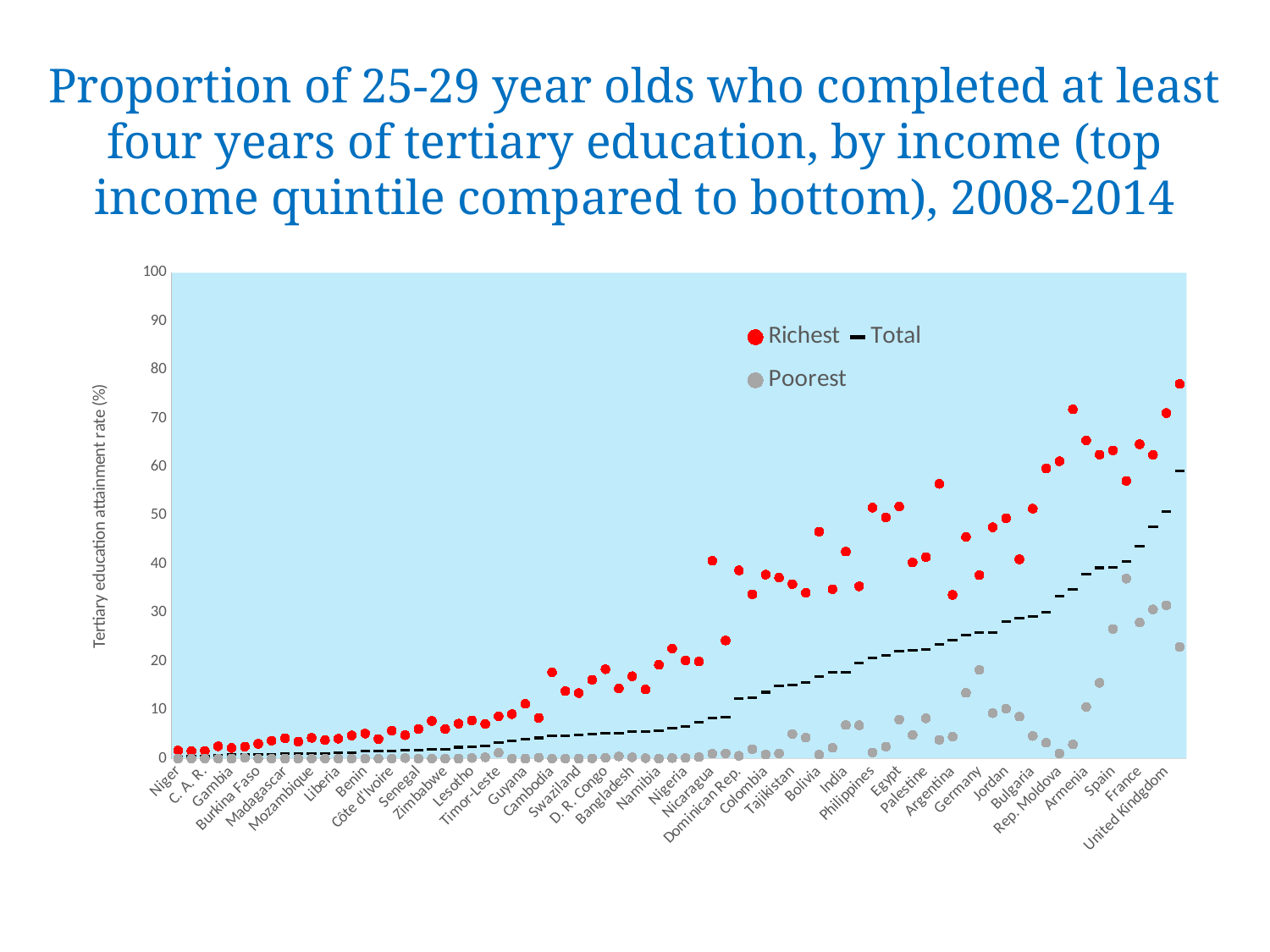
For United Kingdom, which is larger: the Richest value or the Poorest value? Richest What is the label of the vertical axis? Tertiary education attainment rate (%) What kind of chart is shown on the slide? Scatter chart Do the Richest values generally rise or fall moving from Niger on the left to United Kingdom on the right? Rise How many series does the legend list? 3 Which series reaches the highest value on the chart? Richest Is the Richest value for Niger greater or less than 10? less Is the Richest value for United Kingdom greater or less than 70? greater What are the three series named in the legend? Richest, Total, Poorest